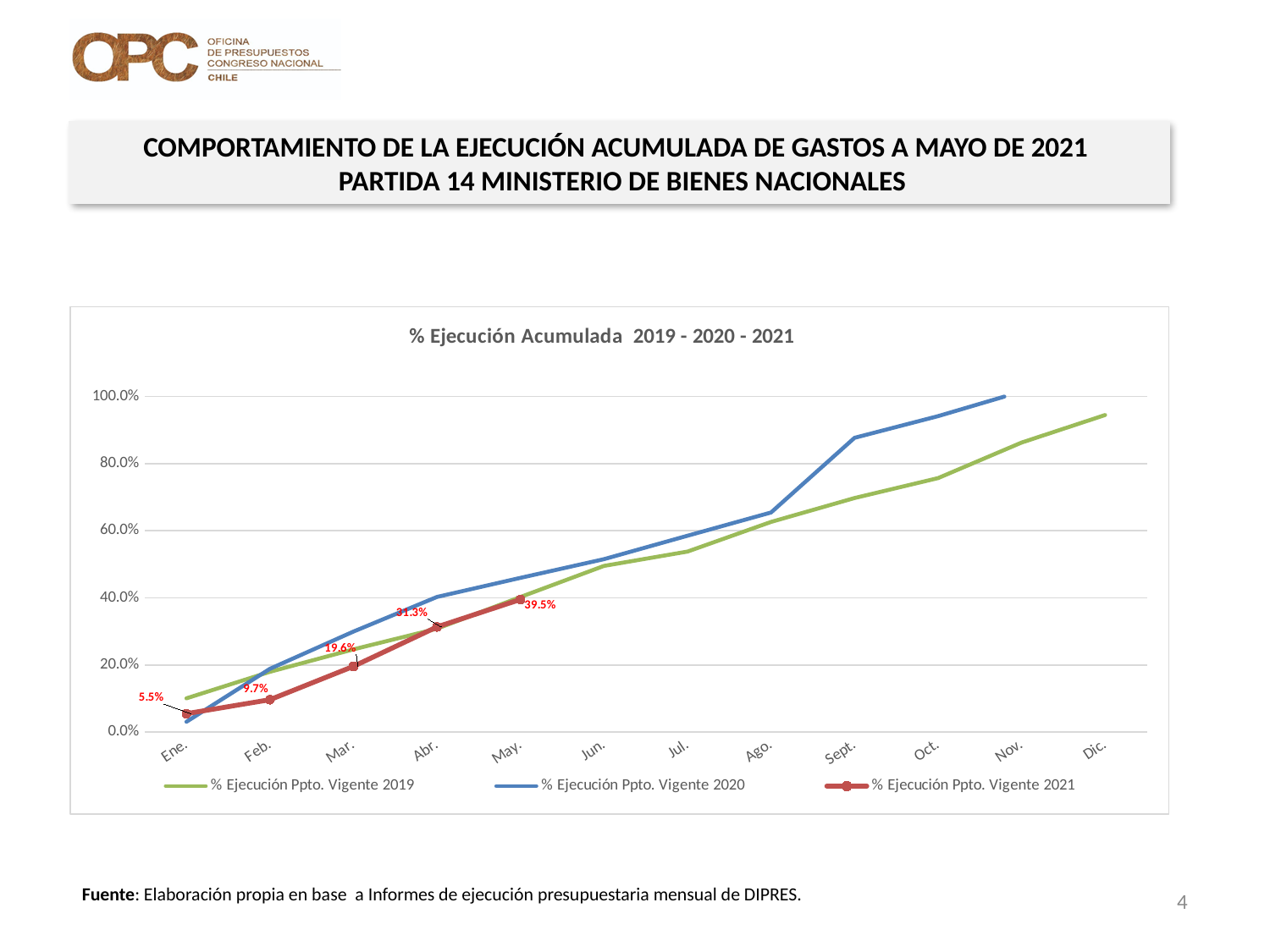
Is the value for Jun. in the % Ejecución Ppto. Vigente 2019 series greater or less than 60.0%? less What is the value for May. in the % Ejecución Ppto. Vigente 2021 series? 39.5% Do the values of the % Ejecución Ppto. Vigente 2021 series rise or fall from Ene. to May.? Rise How many series does the legend list? 3 What is the value for Ene. in the % Ejecución Ppto. Vigente 2021 series? 5.5% Which month has the highest value in the % Ejecución Ppto. Vigente 2021 series? May. What is the difference between the May. and Abr. values in the % Ejecución Ppto. Vigente 2021 series? 8.2% What kind of chart is shown on the slide? Line chart What is the title of the chart? % Ejecución Acumulada 2019 - 2020 - 2021 What is the value for Mar. in the % Ejecución Ppto. Vigente 2021 series? 19.6% Which month has the lowest value in the % Ejecución Ppto. Vigente 2021 series? Ene. Is the value for Nov. in the % Ejecución Ppto. Vigente 2020 series greater or less than 80.0%? greater